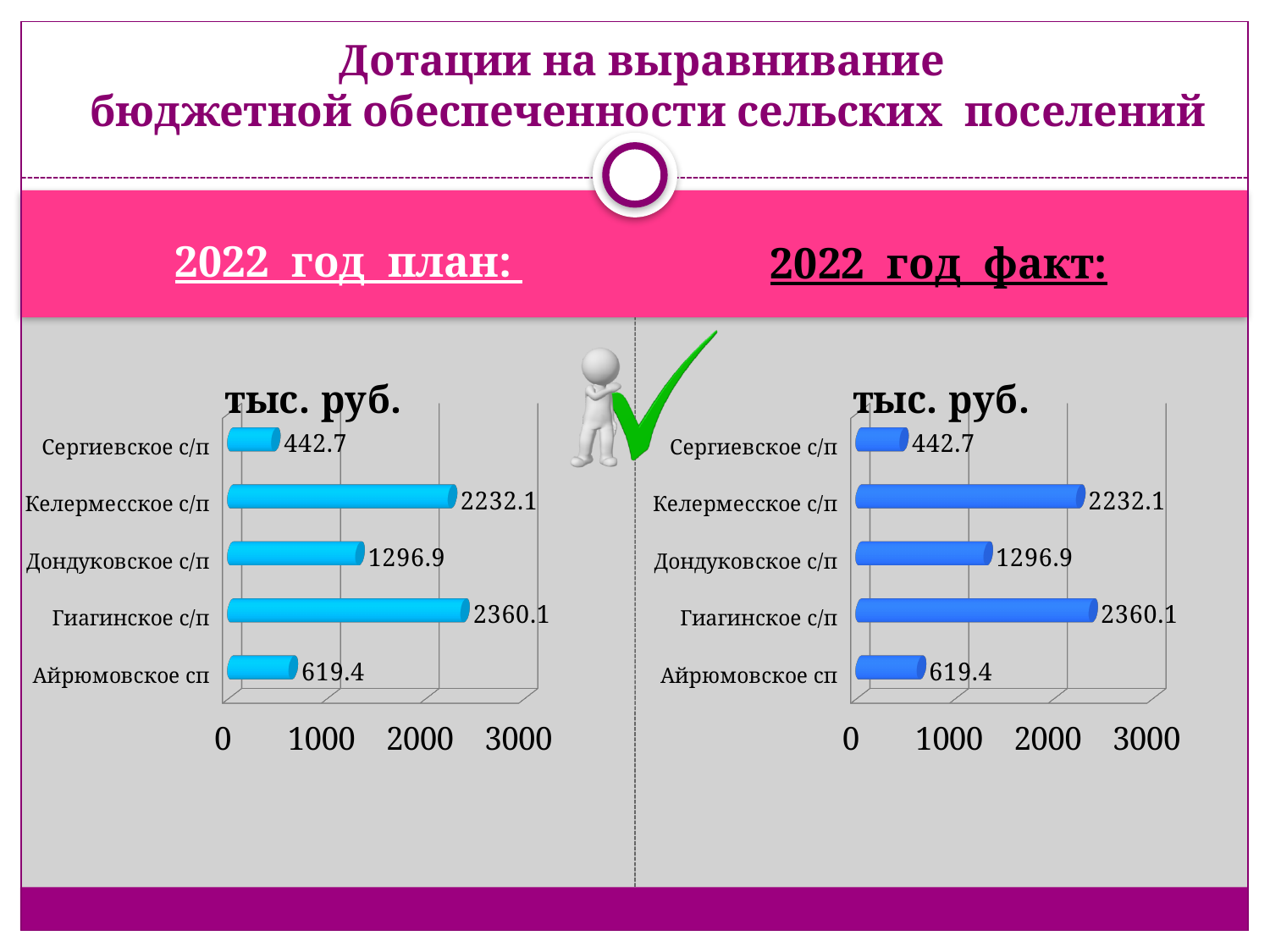
In the left chart (2022 год план), which is larger: the value for Дондуковское с/п or the value for Айрюмовское сп? Дондуковское с/п In the right chart (2022 год факт), what is the value for Гиагинское с/п? 2360.1 In the left chart (2022 год план), what is the difference between the values for Гиагинское с/п and Келермесское с/п? 128 What type of chart is the right chart (2022 год факт)? bar chart In the left chart (2022 год план), what is the value for Келермесское с/п? 2232.1 What unit label is shown above each chart? тыс. руб. In the right chart (2022 год факт), is the value for Сергиевское с/п greater or less than 1000? less How many categories are shown in the left chart (2022 год план)? 5 In the right chart (2022 год факт), which category has the lowest value? Сергиевское с/п In the right chart (2022 год факт), what is the difference between the values for Дондуковское с/п and Айрюмовское сп? 677.5 In the left chart (2022 год план), which category has the highest value? Гиагинское с/п In the right chart (2022 год факт), what is the value for Айрюмовское сп? 619.4